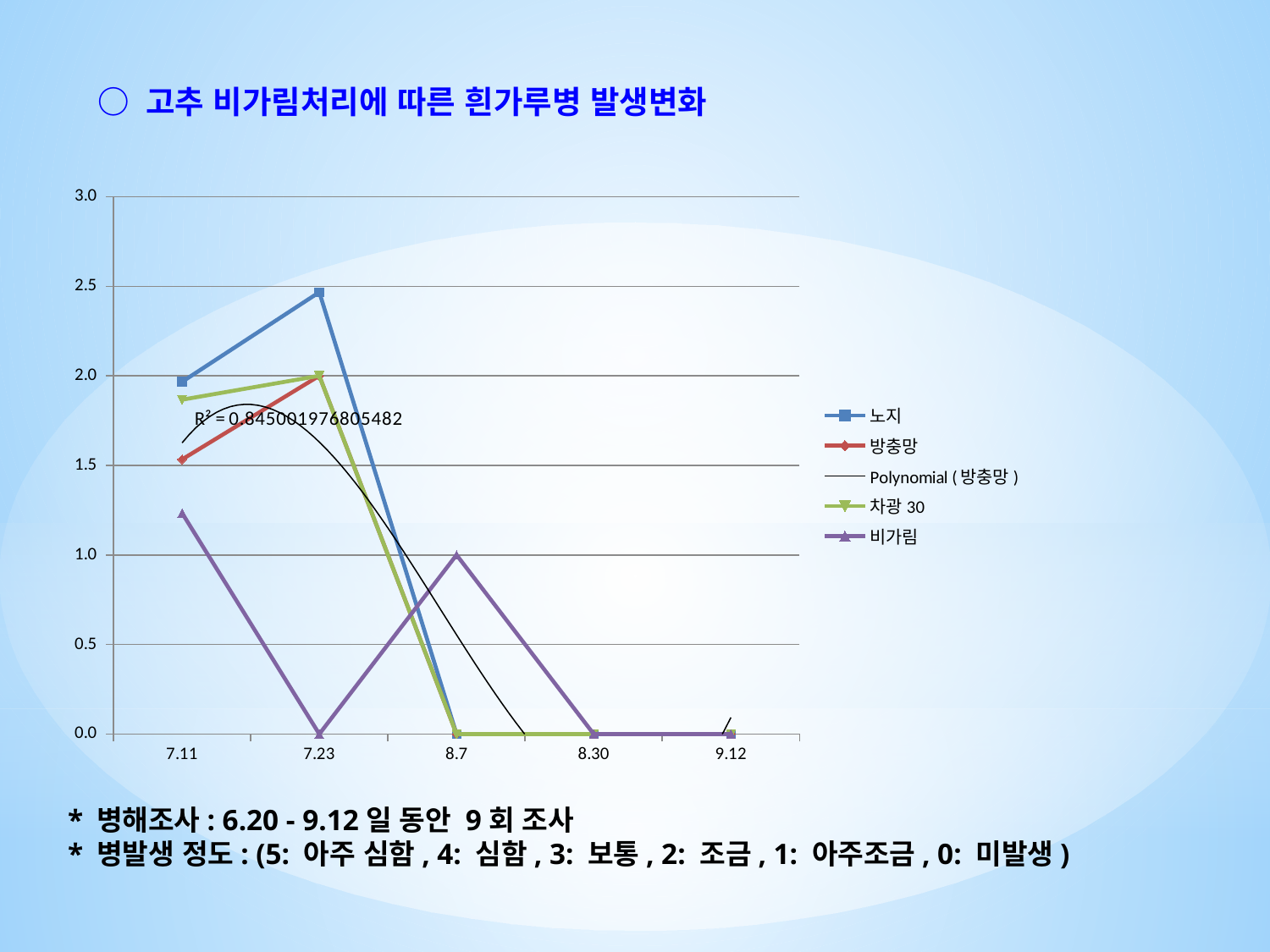
How many series does the legend list? 5 Does the 노지 series rise or fall from 7.23 to 8.7? fall What is the value for 비가림 at 7.23? 0.0 How many dates are shown on the x axis? 5 What is the value for 비가림 at 8.7? 1.0 What kind of chart is shown on the slide? line chart What R² value is printed on the chart? 0.845001976805482 Which series has the lowest value at 7.11? 비가림 Which series has the highest value at 7.23? 노지 Is the value for 비가림 at 7.11 greater or less than 1.0? greater Is the value for 노지 at 7.23 greater or less than 2.0? greater What is the value for 방충망 at 7.23? 2.0